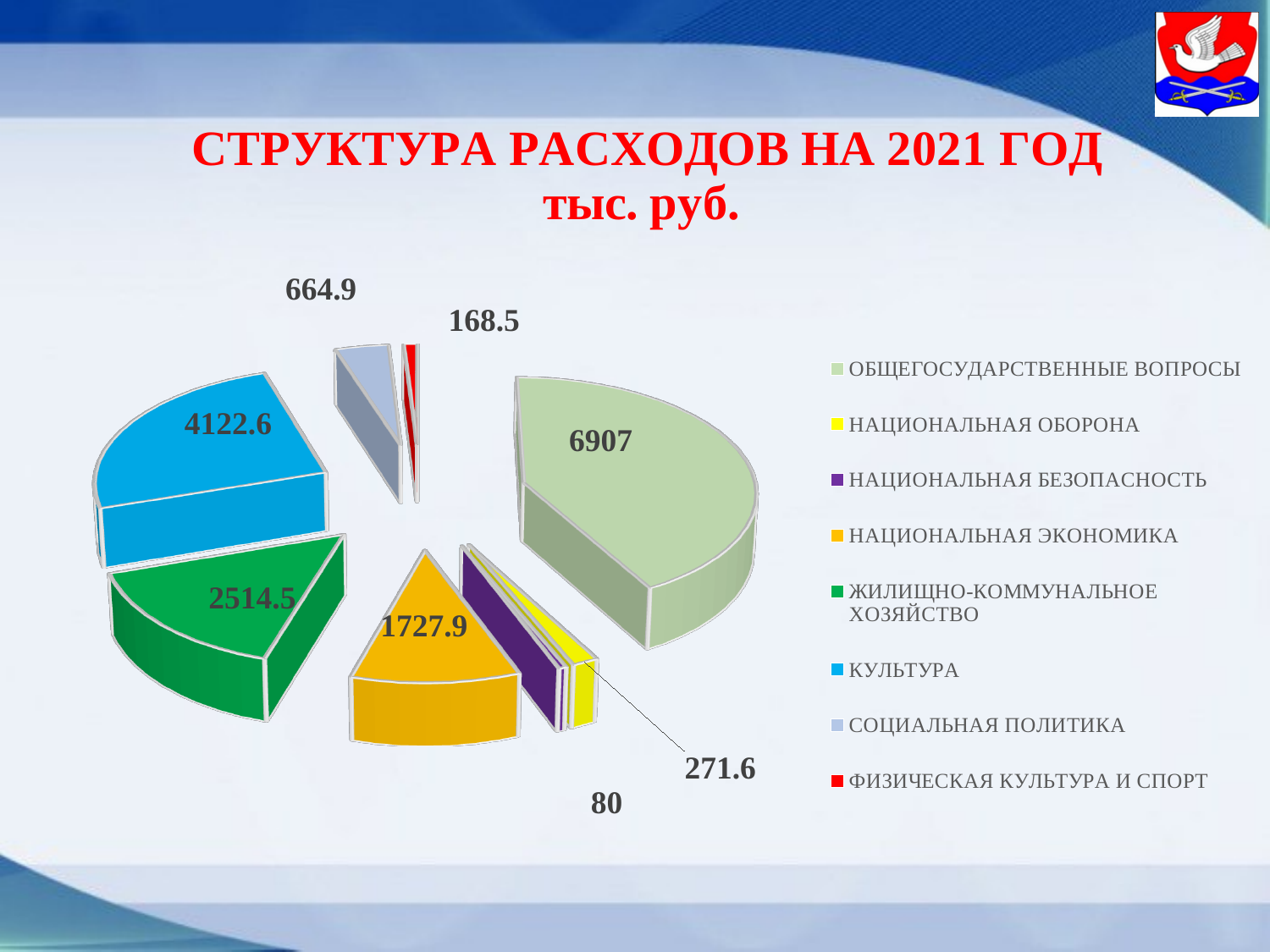
What is the title of the chart? СТРУКТУРА РАСХОДОВ НА 2021 ГОД тыс. руб. Which category has the largest share of the pie? ОБЩЕГОСУДАРСТВЕННЫЕ ВОПРОСЫ What is the value for НАЦИОНАЛЬНАЯ ЭКОНОМИКА? 1727.9 What is the value for ФИЗИЧЕСКАЯ КУЛЬТУРА И СПОРТ? 168.5 What is the value for КУЛЬТУРА? 4122.6 What is the difference between the values for КУЛЬТУРА and ЖИЛИЩНО-КОММУНАЛЬНОЕ ХОЗЯЙСТВО? 1608.1 What is the value for СОЦИАЛЬНАЯ ПОЛИТИКА? 664.9 What type of chart is shown on the slide? Pie chart How many categories does the legend list? 8 What is the value for ОБЩЕГОСУДАРСТВЕННЫЕ ВОПРОСЫ? 6907 Which is larger, КУЛЬТУРА or ЖИЛИЩНО-КОММУНАЛЬНОЕ ХОЗЯЙСТВО? КУЛЬТУРА What is the value for ЖИЛИЩНО-КОММУНАЛЬНОЕ ХОЗЯЙСТВО? 2514.5